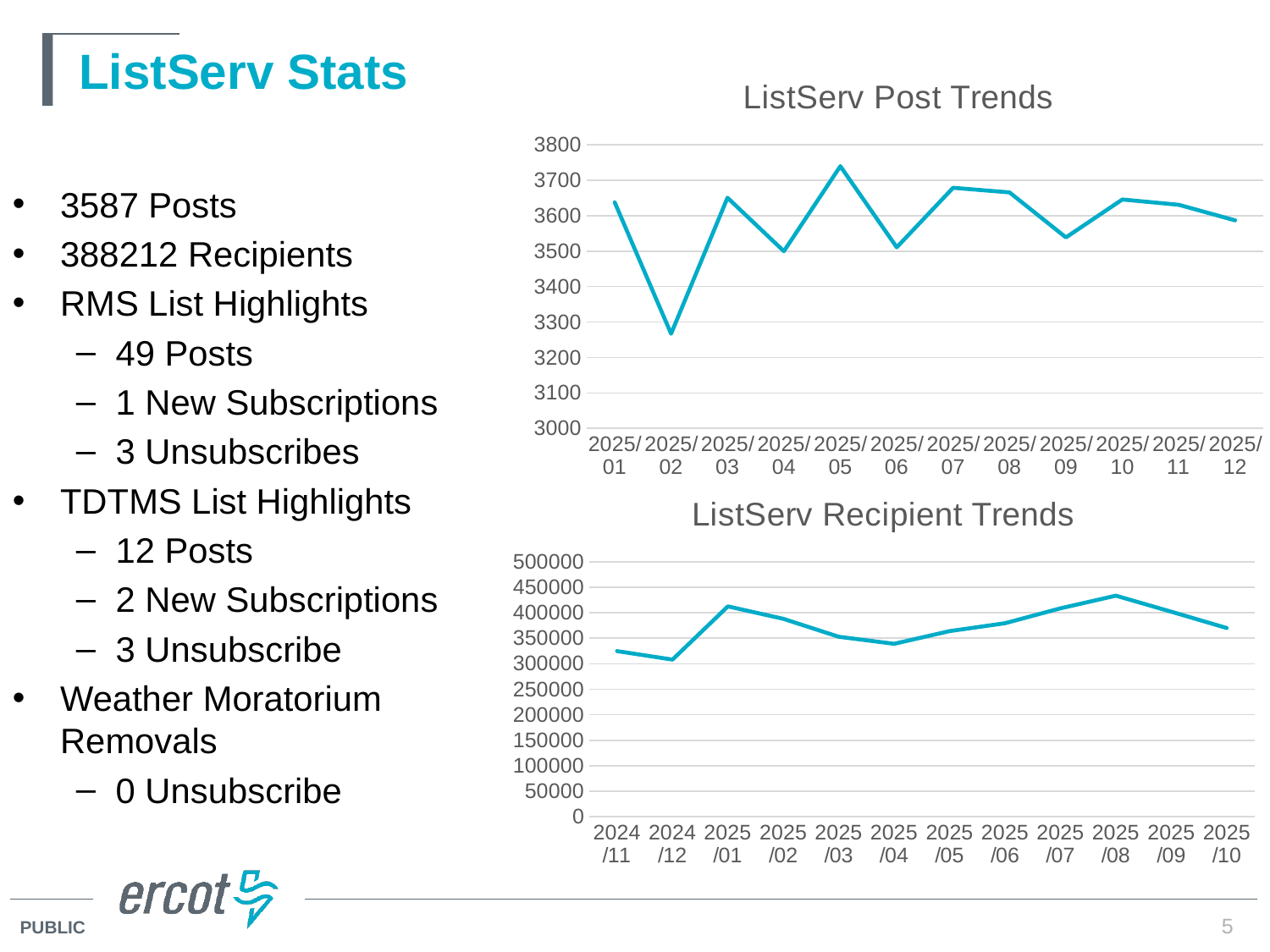
How many data points are plotted on the "ListServ Recipient Trends" chart? 12 On the "ListServ Post Trends" chart, does the value rise or fall from 2025/01 to 2025/02? fall On the "ListServ Post Trends" chart, which is larger, the value for 2025/04 or the value for 2025/07? 2025/07 On the "ListServ Post Trends" chart, is the value for 2025/05 greater or less than 3700? greater On the "ListServ Post Trends" chart, is the value for 2025/02 greater or less than 3300? less On the "ListServ Post Trends" chart, which month has the lowest value? 2025/02 On the "ListServ Post Trends" chart, which month has the highest value? 2025/05 On the "ListServ Recipient Trends" chart, is the value for 2024/12 greater or less than 350000? less On the "ListServ Recipient Trends" chart, which month has the highest value? 2025/08 What is the title of the lower chart on the slide? ListServ Recipient Trends How many data points are plotted on the "ListServ Post Trends" chart? 12 What kind of chart is the "ListServ Post Trends" chart? line chart